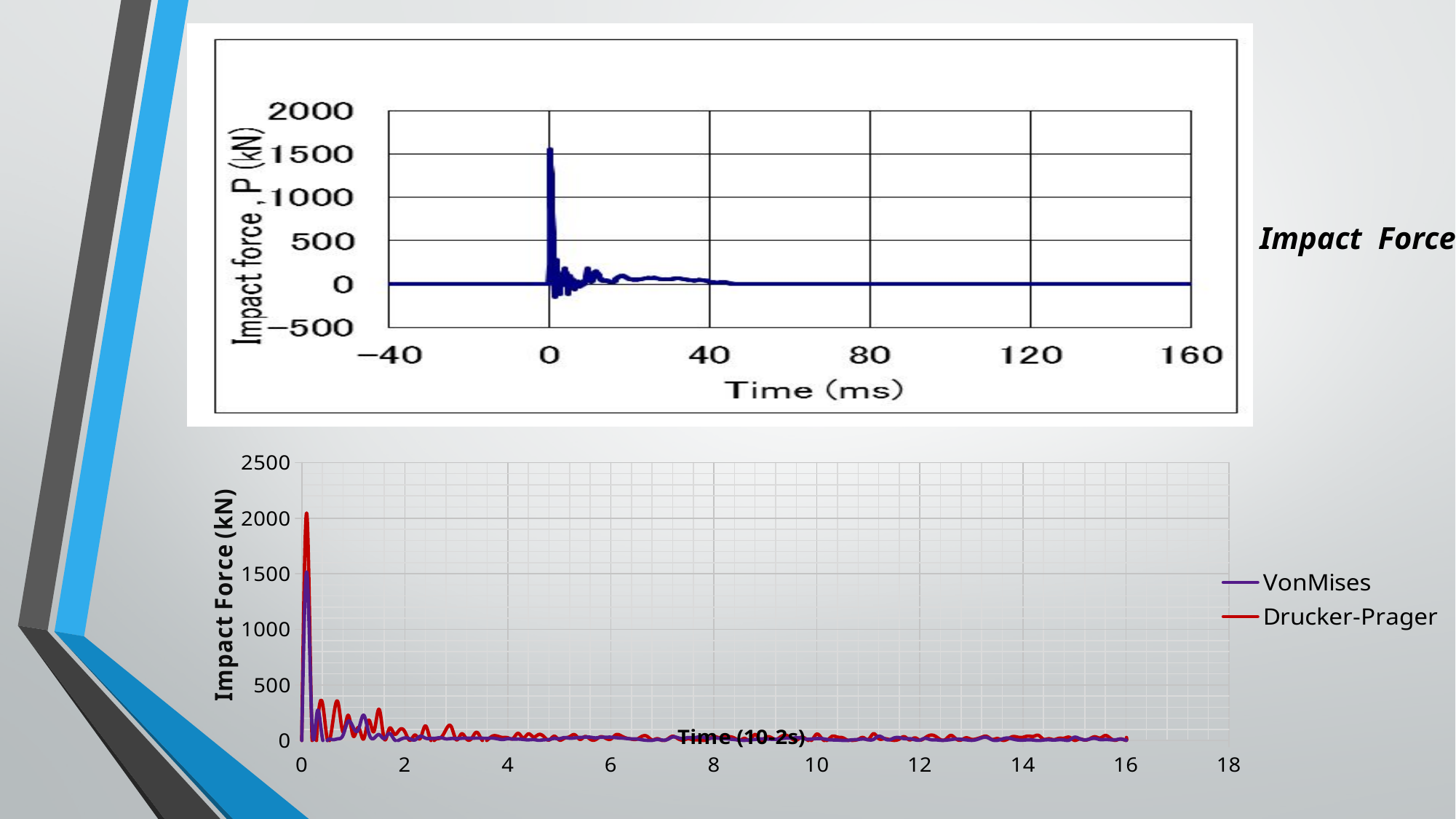
On the bottom chart, which series reaches the higher peak impact force, VonMises or Drucker-Prager? Drucker-Prager On the bottom chart, after the initial peak, do the values generally rise or fall as time increases? fall On the top chart, is the peak impact force greater or less than 2000? less On the bottom chart, how many series does the legend list? 2 On the bottom chart, is the peak value of the VonMises series greater or less than 2000? less On the top chart, at which x-axis tick does the sharp spike in impact force occur? 0 On the bottom chart, is the peak value of the Drucker-Prager series greater or less than 1500? greater What kind of chart is the top chart (Impact force vs Time (ms))? line chart On the bottom chart, what colour is the VonMises series drawn in? purple What kind of chart is the bottom chart? line chart